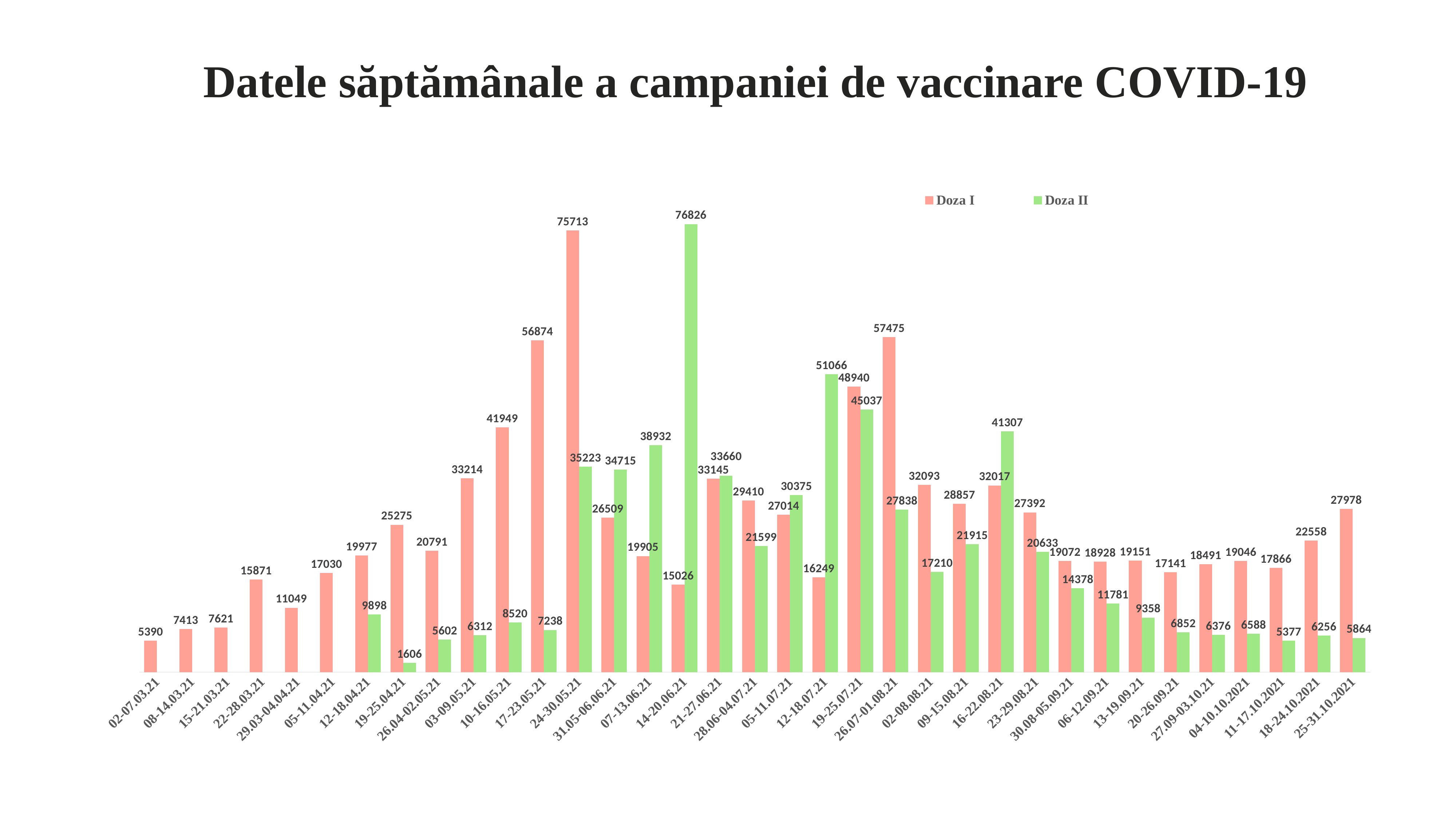
What is the difference between Doza I and Doza II in the week 24-30.05.21? 40490 Which week has the highest Doza II value? 14-20.06.21 What is the Doza II value for the week 14-20.06.21? 76826 Which week has the highest Doza I value? 24-30.05.21 How many weeks are shown on the x axis? 35 How many series does the legend list? 2 What is the Doza II value for the week 19-25.04.21? 1606 Which week has the lowest Doza I value? 02-07.03.21 What is the Doza I value for the week 24-30.05.21? 75713 In the week 12-18.07.21, which is larger: Doza I or Doza II? Doza II What is the Doza I value for the week 25-31.10.2021? 27978 What kind of chart is shown on the slide? Bar chart